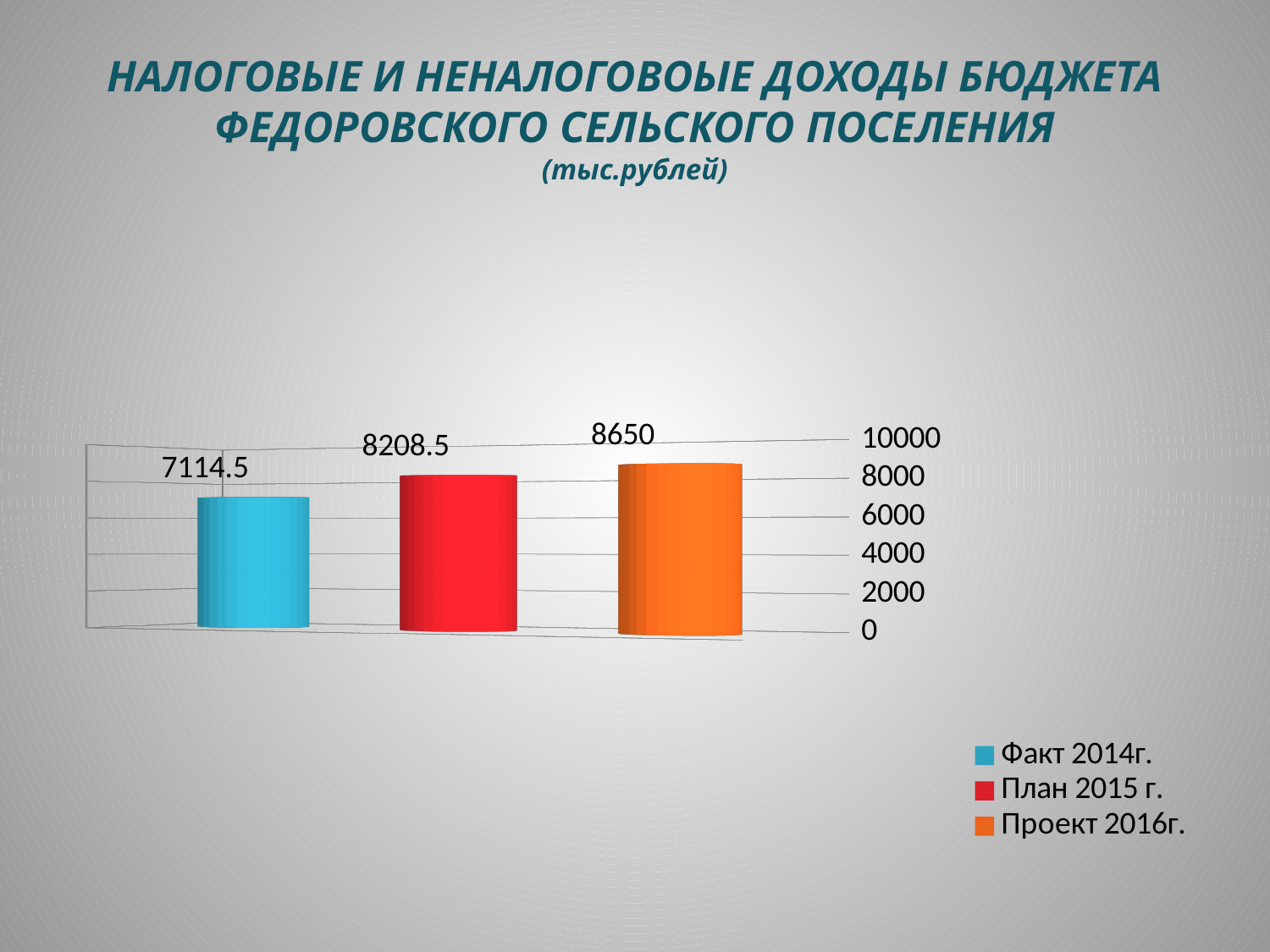
What is the value for Проект 2016г.? 8650 How many series does the legend list? 3 What is the value for Факт 2014г.? 7114.5 How many bars are plotted on the chart? 3 What is the value for План 2015 г.? 8208.5 Which is larger, the value for Факт 2014г. or the value for Проект 2016г.? Проект 2016г. What is the difference between the values for Проект 2016г. and План 2015 г.? 441.5 What kind of chart is shown on the slide? Bar chart What is the difference between the values for План 2015 г. and Факт 2014г.? 1094 Do the values rise or fall from Факт 2014г. to Проект 2016г.? Rise Which series has the lowest value? Факт 2014г. Which series has the highest value? Проект 2016г.